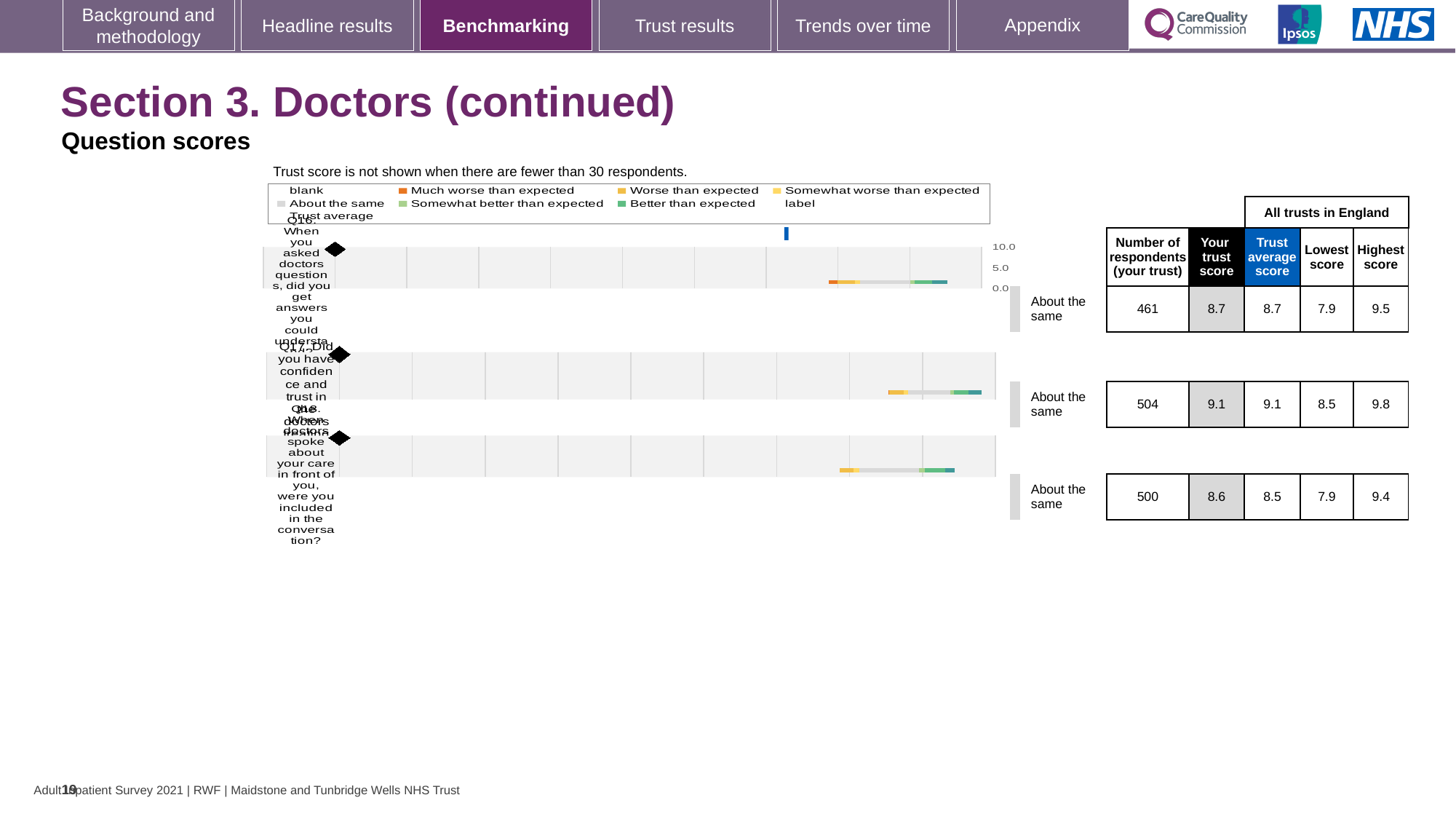
What is the number of respondents for Q17? 504 Which question has the highest 'Your trust score'? Q17 What is the 'Your trust score' value for Q16 (When you asked doctors questions, did you get answers you could understand)? 8.7 What is the 'Trust average score' for Q18 (When doctors spoke about your care in front of you, were you included in the conversation)? 8.5 What kind of chart is used to show the question scores on this slide? bar chart Which is larger, the 'Your trust score' for Q16 or for Q18? Q16 How many questions (categories) are plotted in the chart? 3 What is the 'Your trust score' value for Q17 (Did you have confidence and trust in the doctors treating you)? 9.1 What is the difference between the highest score and the lowest score for Q17? 1.3 Which question has the lowest 'Your trust score'? Q18 What benchmark category is shown next to each of the three questions? About the same Is the trust score for Q17 greater or less than 5.0 on the chart axis? greater